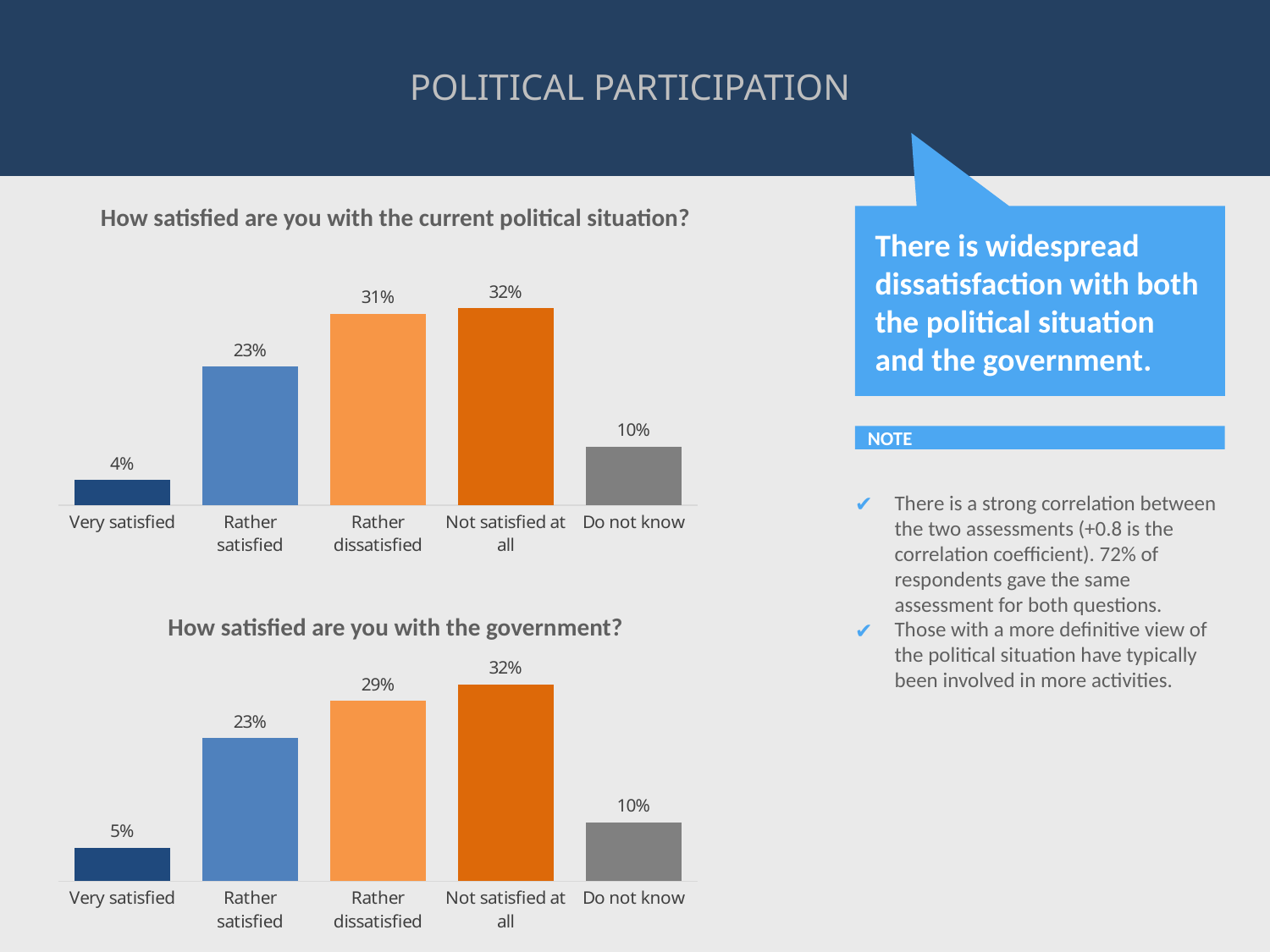
In the chart 'How satisfied are you with the current political situation?', what is the value for 'Rather satisfied'? 23% How many charts are shown on the slide? 2 In the chart 'How satisfied are you with the government?', what is the value for 'Do not know'? 10% In the chart 'How satisfied are you with the government?', which category has the lowest value? Very satisfied What kind of chart is 'How satisfied are you with the government?'? Bar chart In the chart 'How satisfied are you with the current political situation?', what is the value for 'Rather dissatisfied'? 31% In the chart 'How satisfied are you with the government?', what is the value for 'Very satisfied'? 5% In the chart 'How satisfied are you with the government?', which is larger: 'Rather dissatisfied' or 'Rather satisfied'? Rather dissatisfied In the chart 'How satisfied are you with the government?', what is the difference between 'Not satisfied at all' and 'Rather satisfied'? 9% In the chart 'How satisfied are you with the current political situation?', what is the difference between 'Rather satisfied' and 'Very satisfied'? 19% How many categories are shown in the chart 'How satisfied are you with the current political situation?'? 5 In the chart 'How satisfied are you with the current political situation?', which category has the highest value? Not satisfied at all